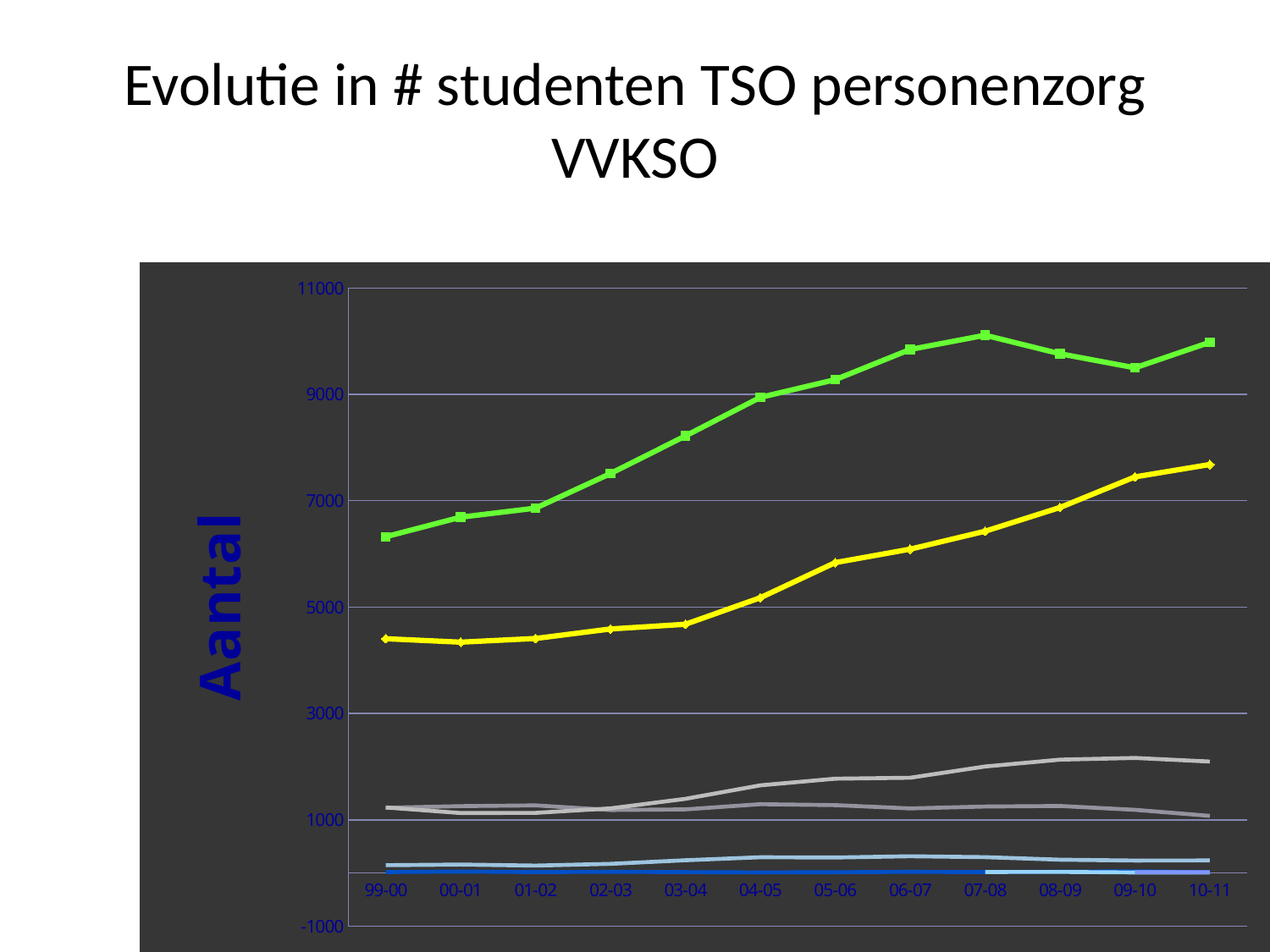
Is the value of the yellow line at 99-00 greater or less than 5000? less Is the value of the yellow line at 10-11 greater or less than 7000? greater In which school year does the yellow line reach its highest value? 10-11 Is the value of the upper grey line at 99-00 greater or less than 2000? less How many school years are shown along the x axis? 12 What kind of chart is shown on the slide? line chart At 10-11, which line has the larger value, the green line or the yellow line? green line What is the label of the vertical axis? Aantal What is the title of the slide containing the chart? Evolutie in # studenten TSO personenzorg VVKSO Does the yellow line generally rise or fall from 99-00 to 10-11? rise